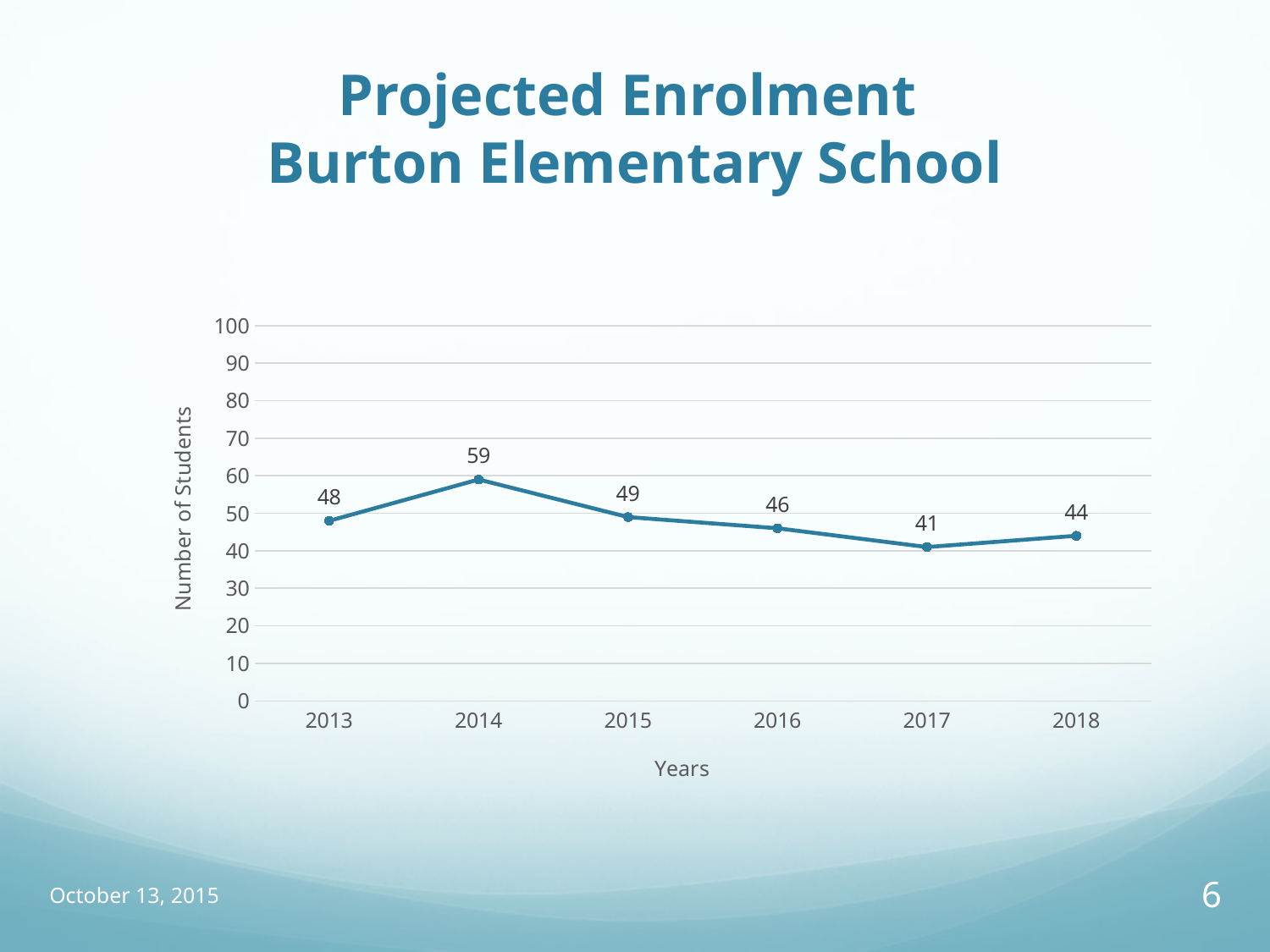
What is the projected enrolment for 2018? 44 Which year has a larger projected enrolment, 2016 or 2018? 2016 What is the projected enrolment for 2014? 59 What is the difference in projected enrolment between 2013 and 2015? 1 What is the projected enrolment for 2017? 41 Which year has the lowest projected enrolment? 2017 Which year has the highest projected enrolment? 2014 What kind of chart is shown on the slide? Line chart What is the label of the vertical axis? Number of Students Is the projected enrolment for 2014 greater or less than 50? greater What is the difference in projected enrolment between 2014 and 2017? 18 How many years are plotted on the chart? 6